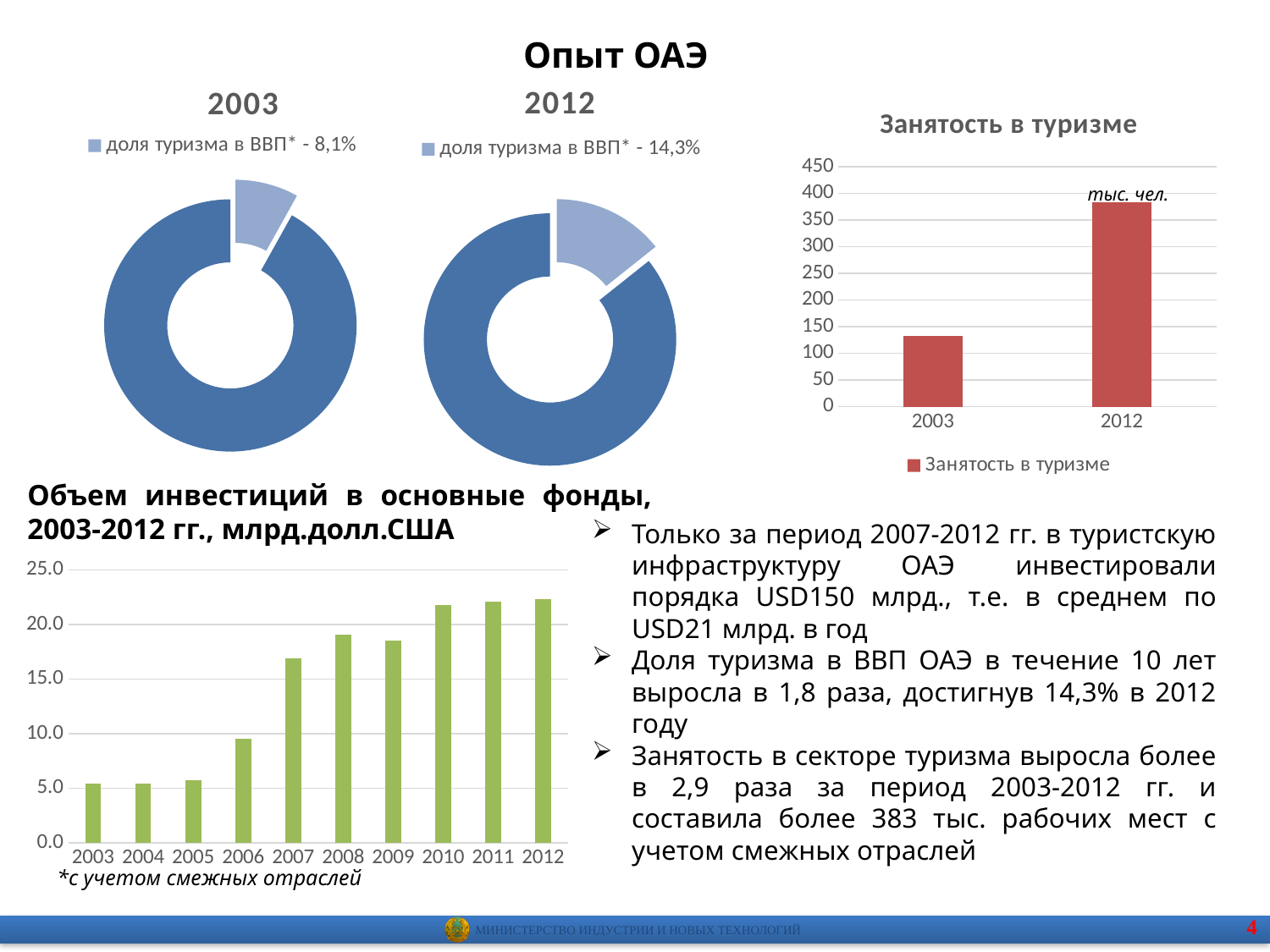
What kind of chart is the 'Занятость в туризме' chart? bar chart In the 2012 donut chart, what share of GDP does tourism account for according to the legend? 14,3% By how many percentage points did the share of tourism in GDP shown in the donut charts increase from 2003 to 2012? 6,2% In the 'Занятость в туризме' chart, is the value for 2003 greater or less than 150? less In the 'Занятость в туризме' chart, is the value for 2012 greater or less than 350? greater In the 'Объем инвестиций в основные фонды' chart, is the value for 2007 greater or less than 15.0? greater In the 2003 donut chart, what share of GDP does tourism account for according to the legend? 8,1% How many categories (years) are shown in the 'Занятость в туризме' chart? 2 In the 'Занятость в туризме' chart, which year has the higher value, 2003 or 2012? 2012 In the 'Занятость в туризме' chart, what unit label is printed near the 2012 bar? тыс. чел. In the 'Объем инвестиций в основные фонды' chart, do the values generally rise or fall from 2003 to 2012? rise How many years are shown on the x axis of the 'Объем инвестиций в основные фонды' chart? 10